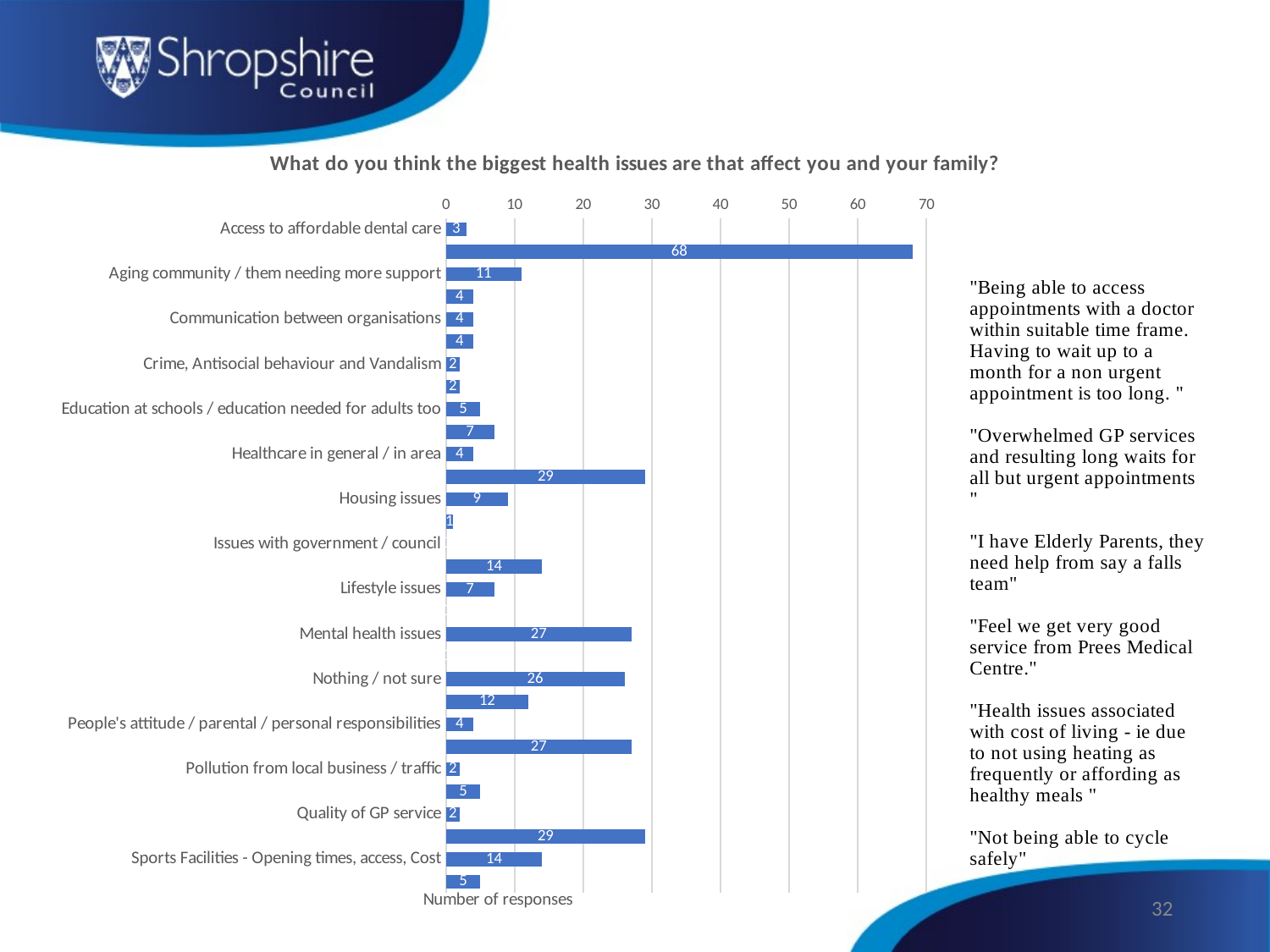
What is the label on the horizontal axis of the chart? Number of responses How many responses are shown for Aging community / them needing more support? 11 Which has more responses, Housing issues or Lifestyle issues? Housing issues Is the value for Nothing / not sure greater or less than 20? greater How many responses are shown for Housing issues? 9 What is the title of the chart? What do you think the biggest health issues are that affect you and your family? What type of chart is shown on the slide? bar chart How many responses are shown for Sports Facilities - Opening times, access, Cost? 14 How many responses are shown for Mental health issues? 27 What is the largest value shown on any bar in the chart? 68 What is the difference in responses between Sports Facilities - Opening times, access, Cost and Housing issues? 5 How many responses are shown for Access to affordable dental care? 3